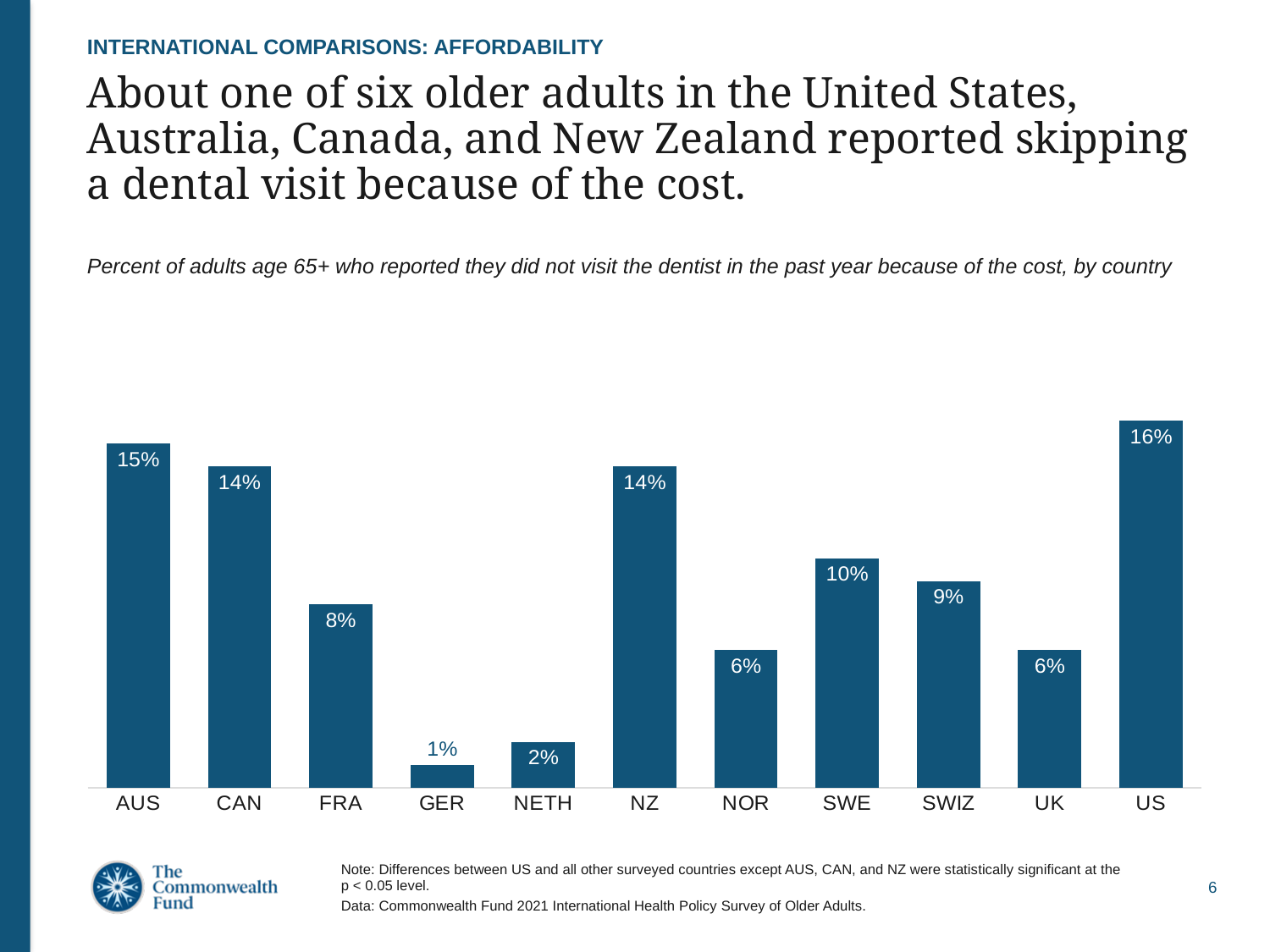
What percent of adults age 65+ in Australia (AUS) reported not visiting the dentist because of the cost? 15% Which has a higher value, the Netherlands (NETH) or Norway (NOR)? NOR What is the value shown for Sweden (SWE)? 10% Which has a higher value, Canada (CAN) or Sweden (SWE)? CAN Which two countries share the same value of 14%? CAN and NZ What is the value shown for Germany (GER)? 1% Which country has the highest percentage of older adults who skipped a dental visit because of cost? US Which country has the lowest value on the chart? GER What type of chart is shown on the slide? Bar chart What is the difference between the values for the US and France (FRA)? 8% How many countries are shown on the chart? 11 What is the difference between the values for Switzerland (SWIZ) and the UK? 3%